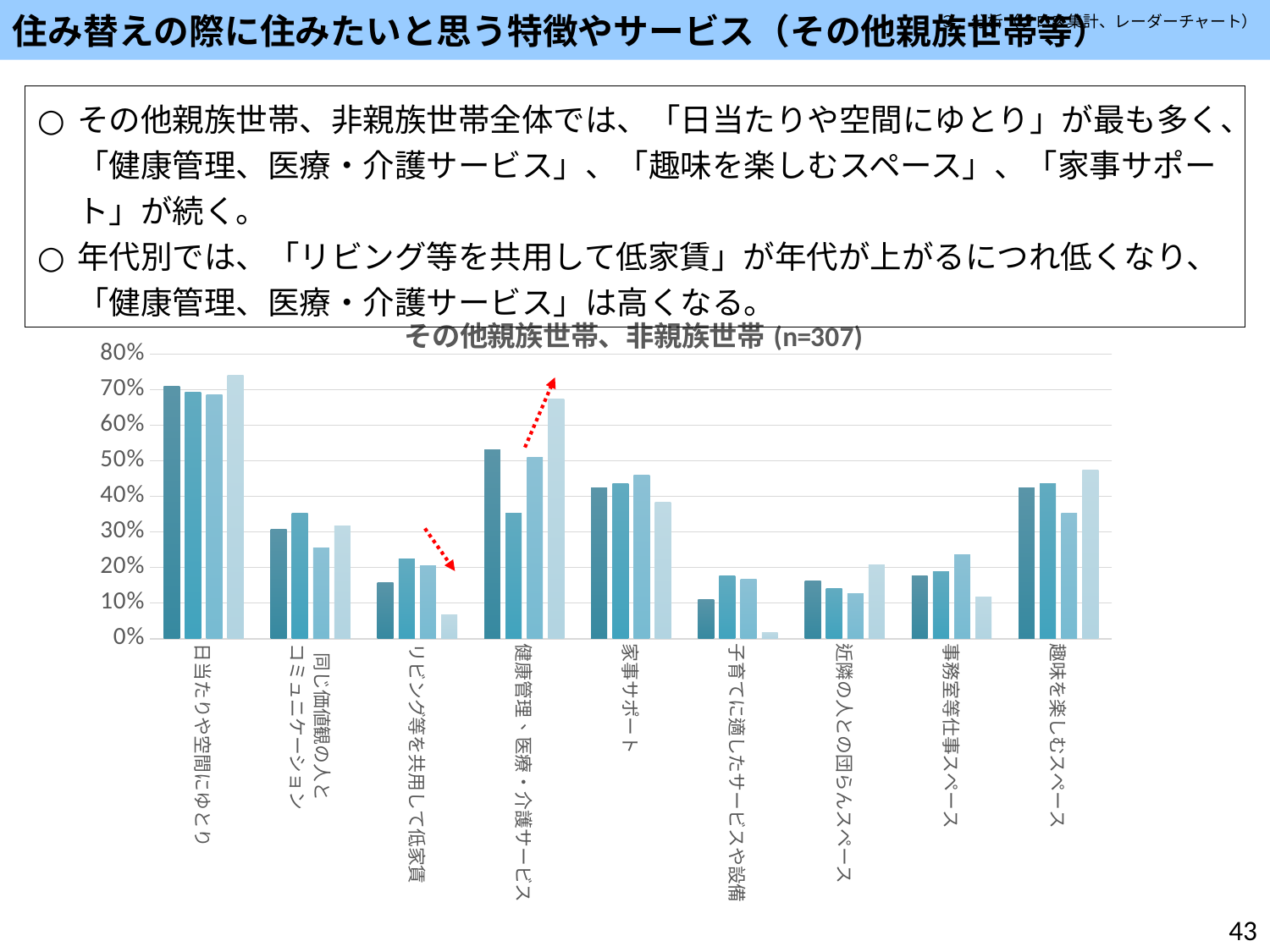
Which is larger: the leftmost bar for 日当たりや空間にゆとり or the leftmost bar for 健康管理、医療・介護サービス? 日当たりや空間にゆとり Which category has the tallest bar in the chart? 日当たりや空間にゆとり Is the value of the leftmost bar for 家事サポート greater or less than 50%? less Is the value of the rightmost bar for 健康管理、医療・介護サービス greater or less than 60%? greater How many bars are plotted for each category in the chart? 4 Is the value of the leftmost bar for 日当たりや空間にゆとり greater or less than 60%? greater What sample size (n) is given in the chart title? 307 What kind of chart is shown on the slide? bar chart What is the title of the chart? その他親族世帯、非親族世帯 (n=307) Which category contains the shortest bar in the chart? 子育てに適したサービスや設備 How many categories are shown along the x axis of the chart? 9